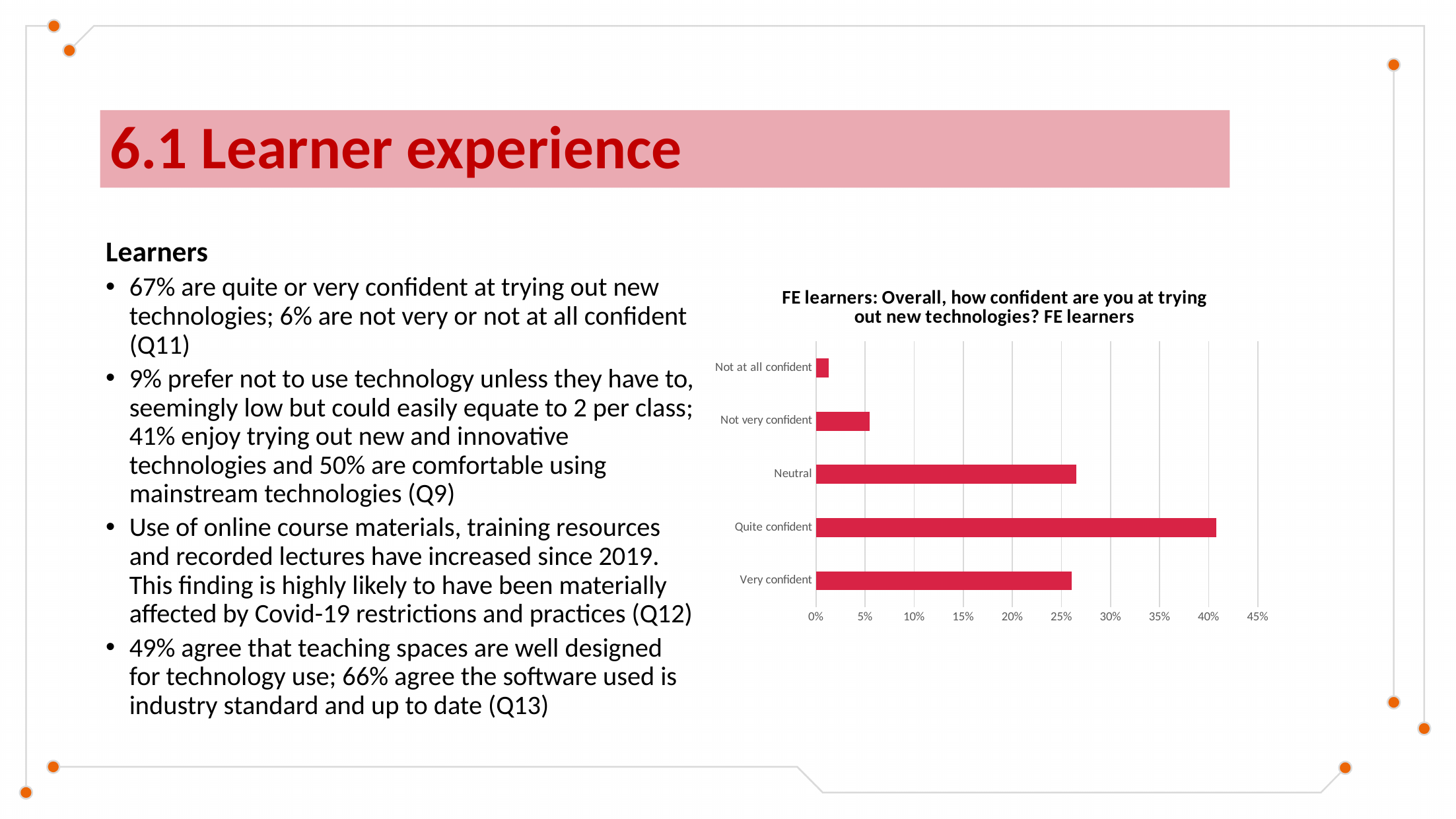
Which category has the lowest value in the chart? Not at all confident Which is larger, the value for Quite confident or the value for Neutral? Quite confident Is the value for Not at all confident greater or less than 5%? less Which category has the highest value in the chart? Quite confident How many categories are shown in the chart? 5 Is the value for Very confident greater or less than 20%? greater Is the value for Not very confident greater or less than 10%? less Which is larger, the value for Not very confident or the value for Very confident? Very confident What is the title of the chart? FE learners: Overall, how confident are you at trying out new technologies? FE learners What type of chart is shown on the slide? bar chart